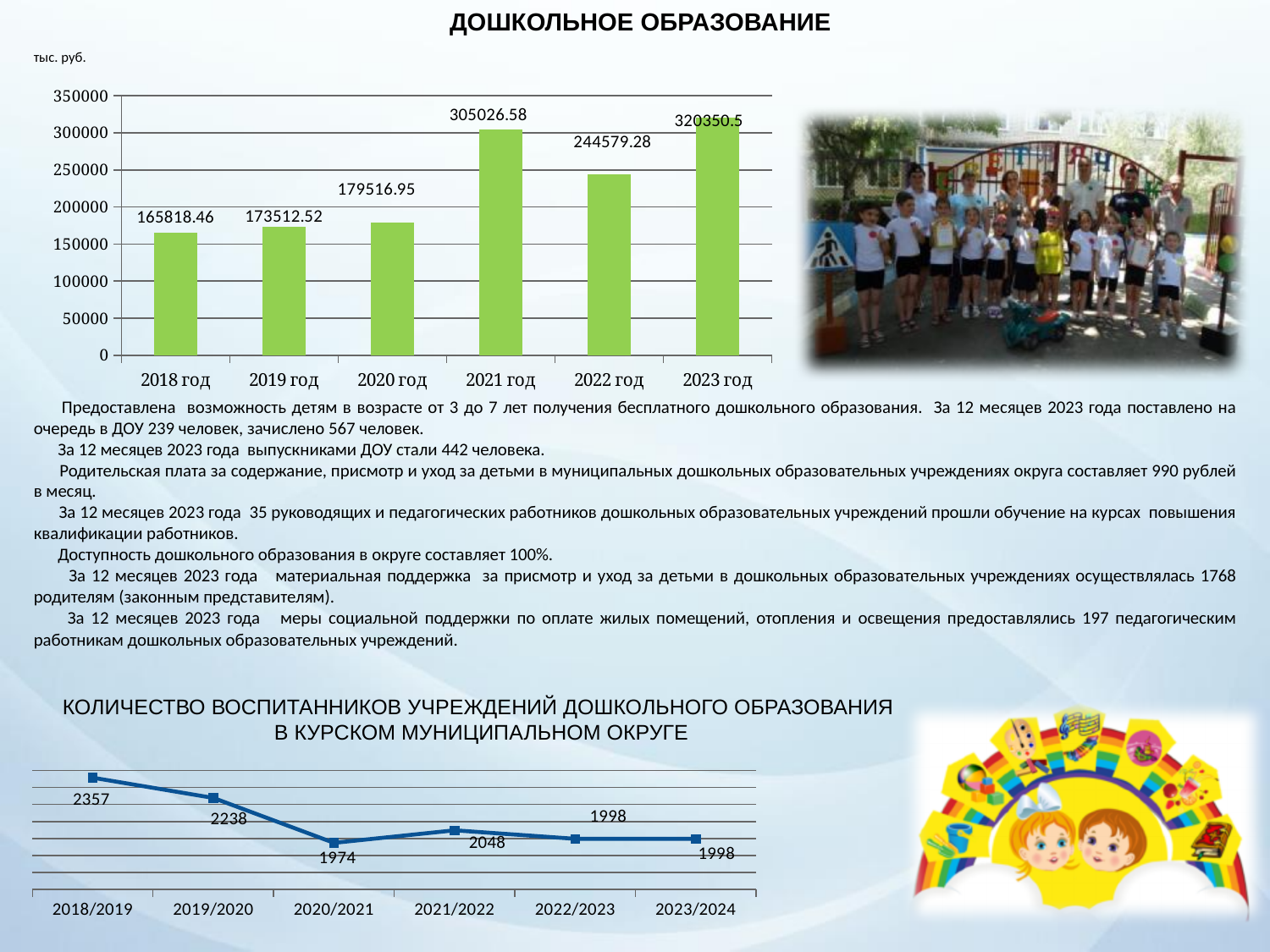
What type of chart is the top chart on the slide? bar chart On the top bar chart, which year has the highest value? 2023 год On the top bar chart, what is the difference between the values for 2023 год and 2022 год? 75771.22 On the top bar chart, which year has the lowest value? 2018 год On the bottom line chart (Количество воспитанников учреждений дошкольного образования), what is the difference between the values for 2018/2019 and 2019/2020? 119 On the top bar chart, which is larger: the value for 2021 год or 2022 год? 2021 год On the top bar chart, what is the value for 2018 год? 165818.46 On the bottom line chart (Количество воспитанников учреждений дошкольного образования), what is the value for 2020/2021? 1974 On the bottom line chart (Количество воспитанников учреждений дошкольного образования), which school year has the highest value? 2018/2019 On the top bar chart, how many years are shown? 6 On the top bar chart, what is the value for 2021 год? 305026.58 What unit is indicated above the top bar chart? тыс. руб.